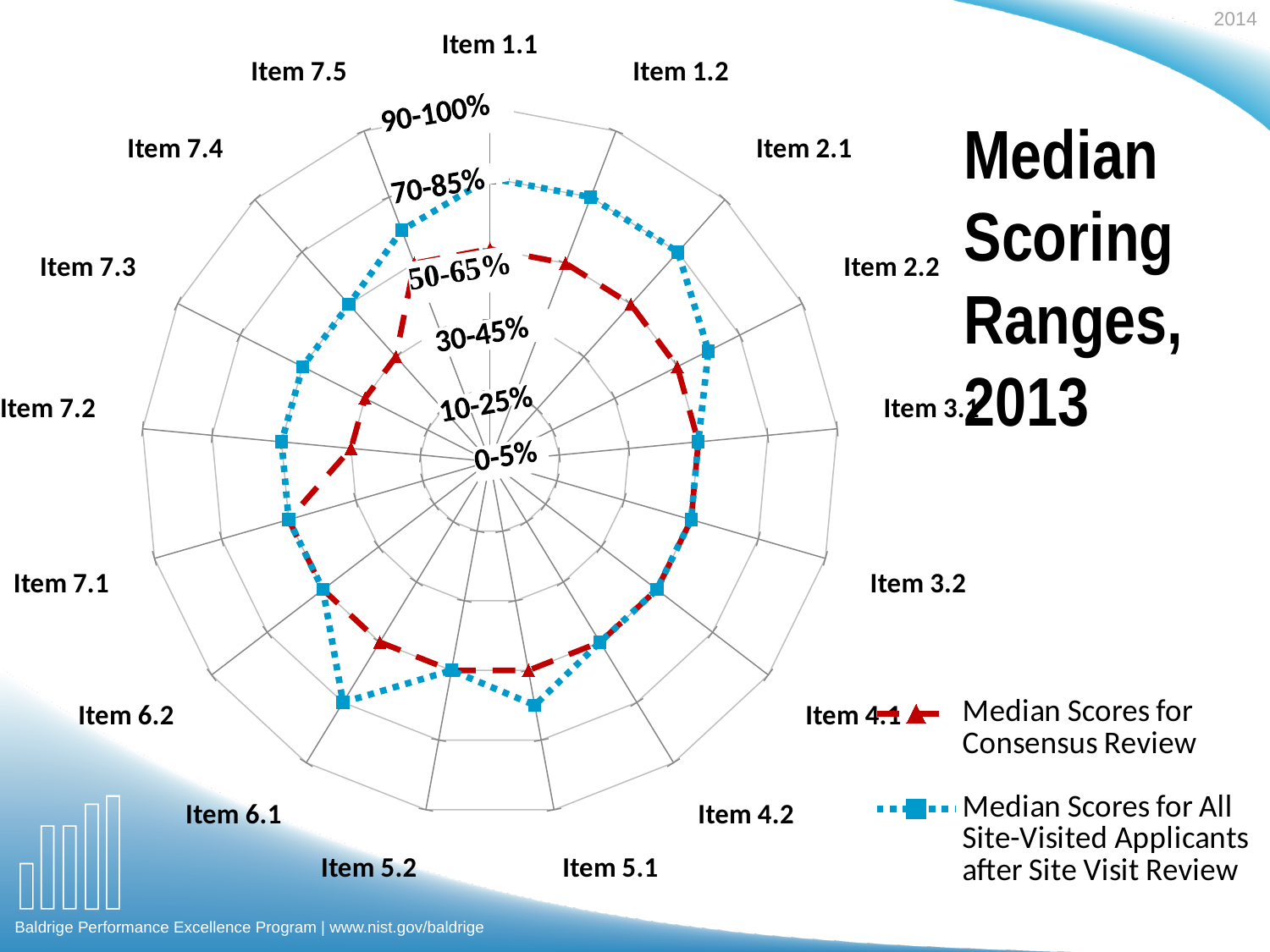
How many items (categories) are plotted around the radar chart? 17 How many scoring-range rings are labelled on the chart? 6 What is the title of the chart on the slide? Median Scoring Ranges, 2013 On which scoring-range ring does the Median Scores for All Site-Visited Applicants point for Item 7.2 lie? 50-65% How many series does the chart's legend list? 2 On which scoring-range ring does the Median Scores for Consensus Review point for Item 1.1 lie? 50-65% For Item 6.1, which series has the higher median scoring range: Consensus Review or Site-Visited Applicants after Site Visit Review? Site-Visited Applicants after Site Visit Review Which series is drawn with the red dashed line and triangle markers? Median Scores for Consensus Review For Item 1.1, which series has the higher median scoring range: Consensus Review or Site-Visited Applicants after Site Visit Review? Site-Visited Applicants after Site Visit Review For Item 7.3, which series has the higher median scoring range: Consensus Review or Site-Visited Applicants after Site Visit Review? Site-Visited Applicants after Site Visit Review What kind of chart is shown on the slide? Radar chart On which scoring-range ring does the Median Scores for All Site-Visited Applicants point for Item 1.1 lie? 70-85%